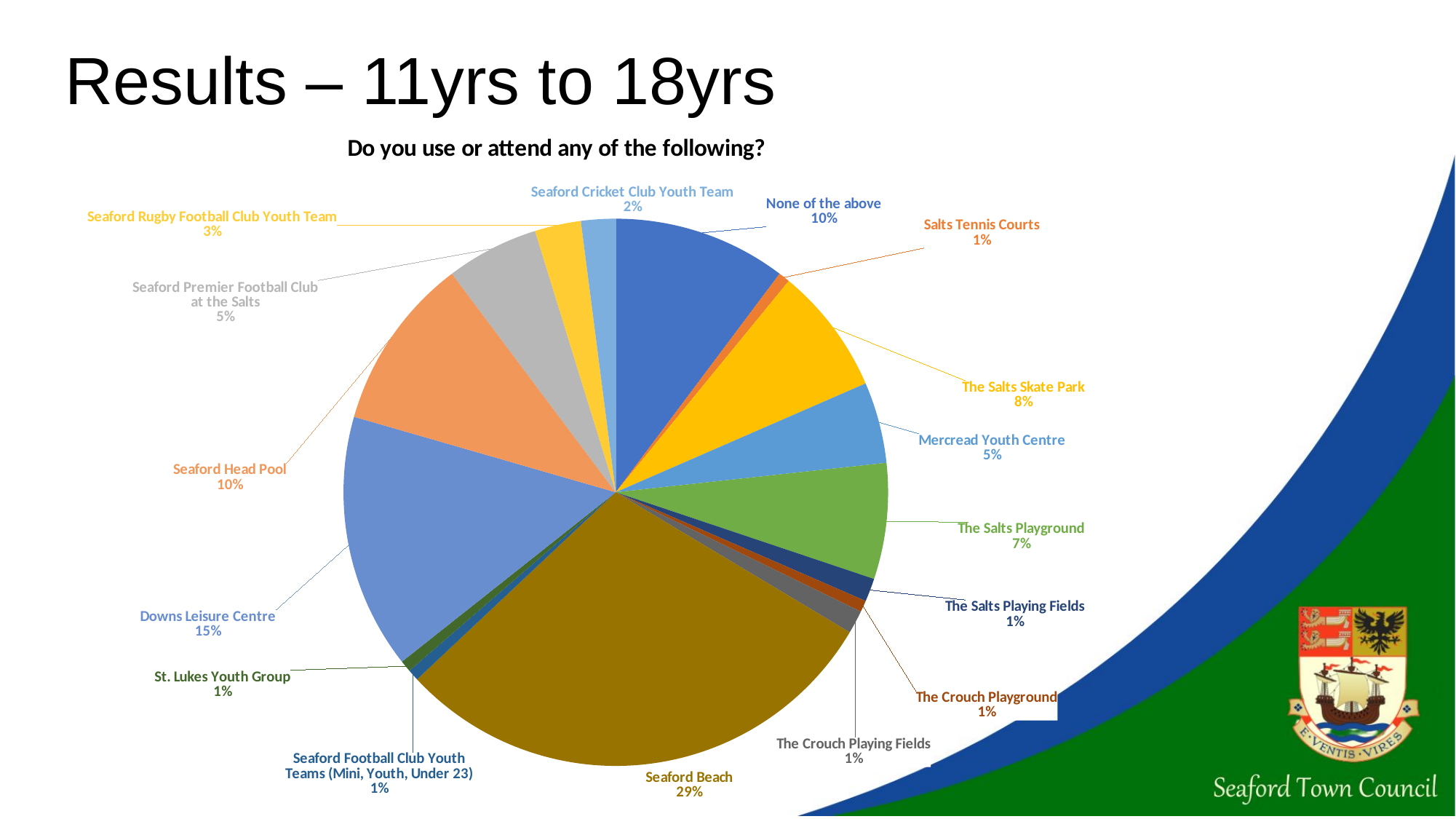
Which is larger, The Salts Playground or Mercread Youth Centre? The Salts Playground What is the combined share of None of the above and Seaford Head Pool? 20% What percentage of respondents use or attend Seaford Beach? 29% What is the difference between the Seaford Beach share and the Downs Leisure Centre share? 14% What share of the pie does Downs Leisure Centre represent? 15% What is the value for The Salts Skate Park? 8% What is the title of the chart? Do you use or attend any of the following? What percentage is shown for Seaford Head Pool? 10% Which category has the largest slice of the pie? Seaford Beach What type of chart is shown on the slide? pie chart What percentage is shown for Seaford Rugby Football Club Youth Team? 3% How many categories are shown in the pie chart? 16